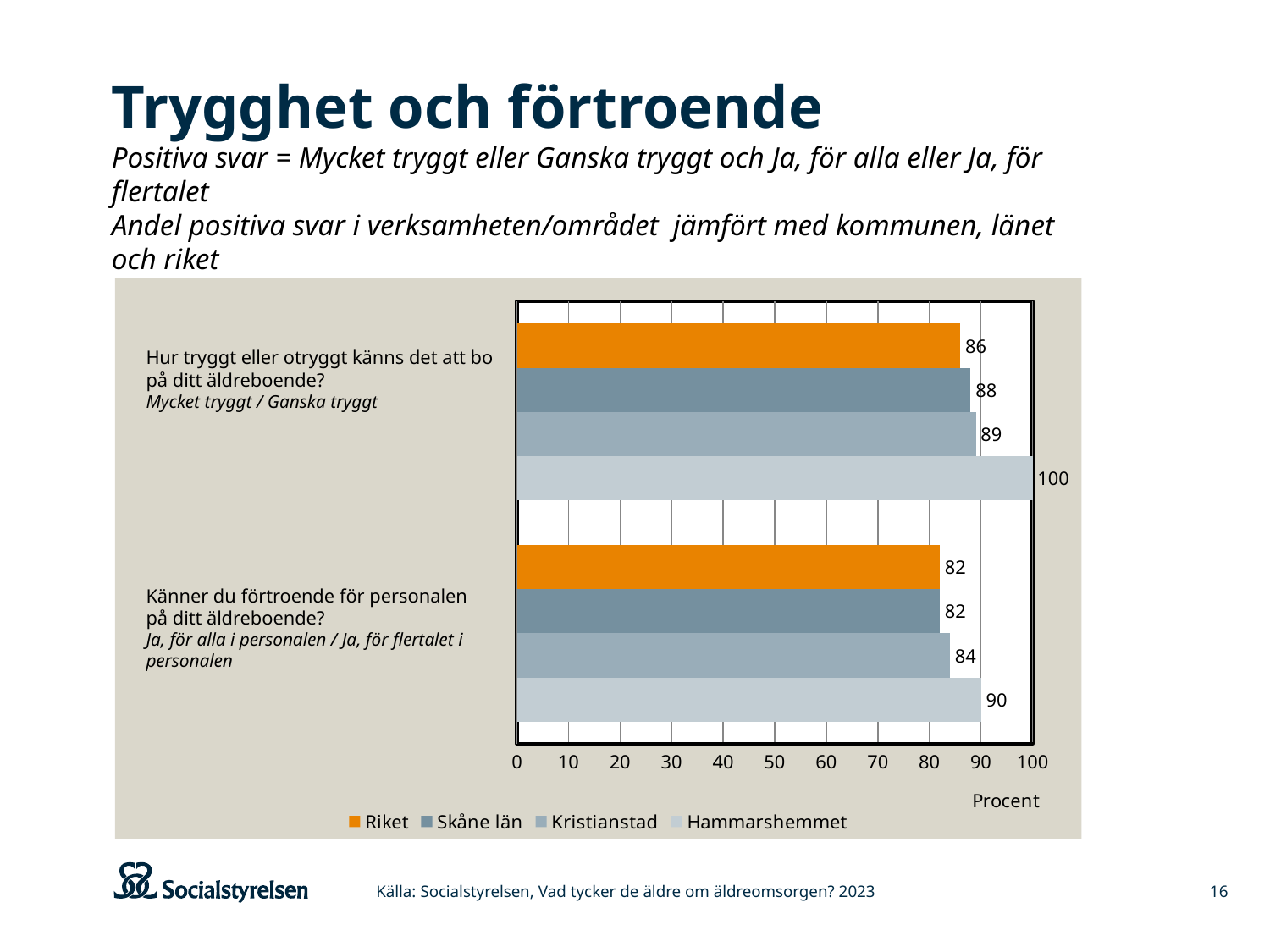
What is the value for Riket on the question "Känner du förtroende för personalen på ditt äldreboende?"? 82 What is the difference between Hammarshemmet and Kristianstad on the question "Känner du förtroende för personalen på ditt äldreboende?"? 6 What kind of chart is shown on the slide? Bar chart How many series does the legend list? 4 What is the value for Hammarshemmet on the question "Hur tryggt eller otryggt känns det att bo på ditt äldreboende?"? 100 Which series has the lowest value on the question "Hur tryggt eller otryggt känns det att bo på ditt äldreboende?"? Riket Which is larger: Kristianstad's value on the trust-in-staff question ("Känner du förtroende för personalen") or Skåne län's value on the same question? Kristianstad Which series has the highest value on the question "Känner du förtroende för personalen på ditt äldreboende?"? Hammarshemmet What is the value for Kristianstad on the question "Hur tryggt eller otryggt känns det att bo på ditt äldreboende?"? 89 What is the value for Skåne län on the question "Känner du förtroende för personalen på ditt äldreboende?"? 82 What is the difference between Hammarshemmet and Riket on the question "Hur tryggt eller otryggt känns det att bo på ditt äldreboende?"? 14 What is the label of the x axis? Procent